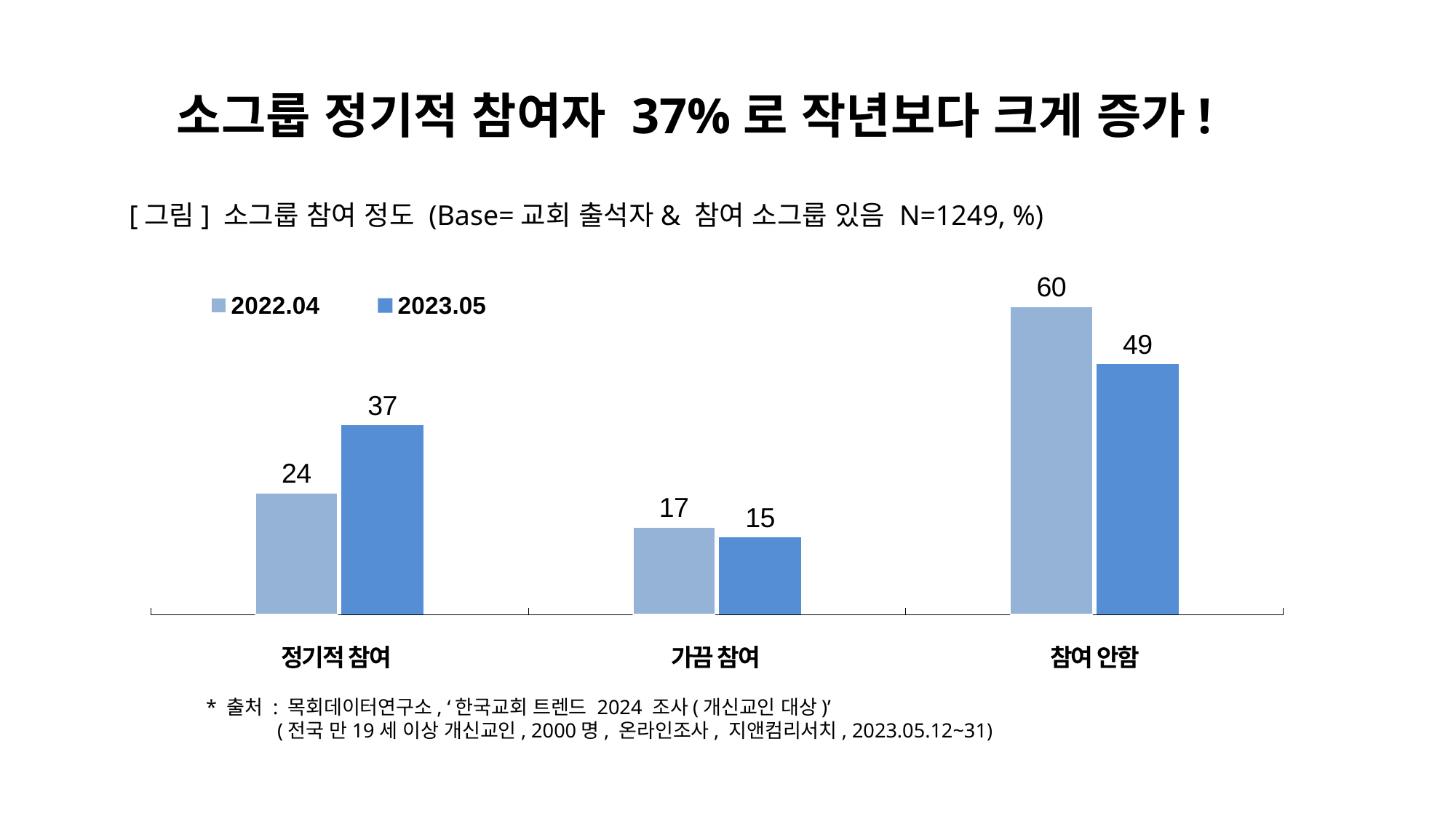
What is the difference between the 2022.04 and 2023.05 values for 참여 안함? 11 Which category has the highest value in the 2023.05 series? 참여 안함 What is the value for 참여 안함 in the 2022.04 series? 60 How many categories are shown on the x axis? 3 What are the two series names listed in the legend? 2022.04 and 2023.05 Which is larger for 가끔 참여: the 2022.04 value or the 2023.05 value? 2022.04 What kind of chart is shown on the slide? Bar chart Which category has the lowest value in the 2022.04 series? 가끔 참여 What is the value for 정기적 참여 in the 2023.05 series? 37 What is the value for 가끔 참여 in the 2023.05 series? 15 How many series does the legend list? 2 What is the difference between the 2023.05 and 2022.04 values for 정기적 참여? 13